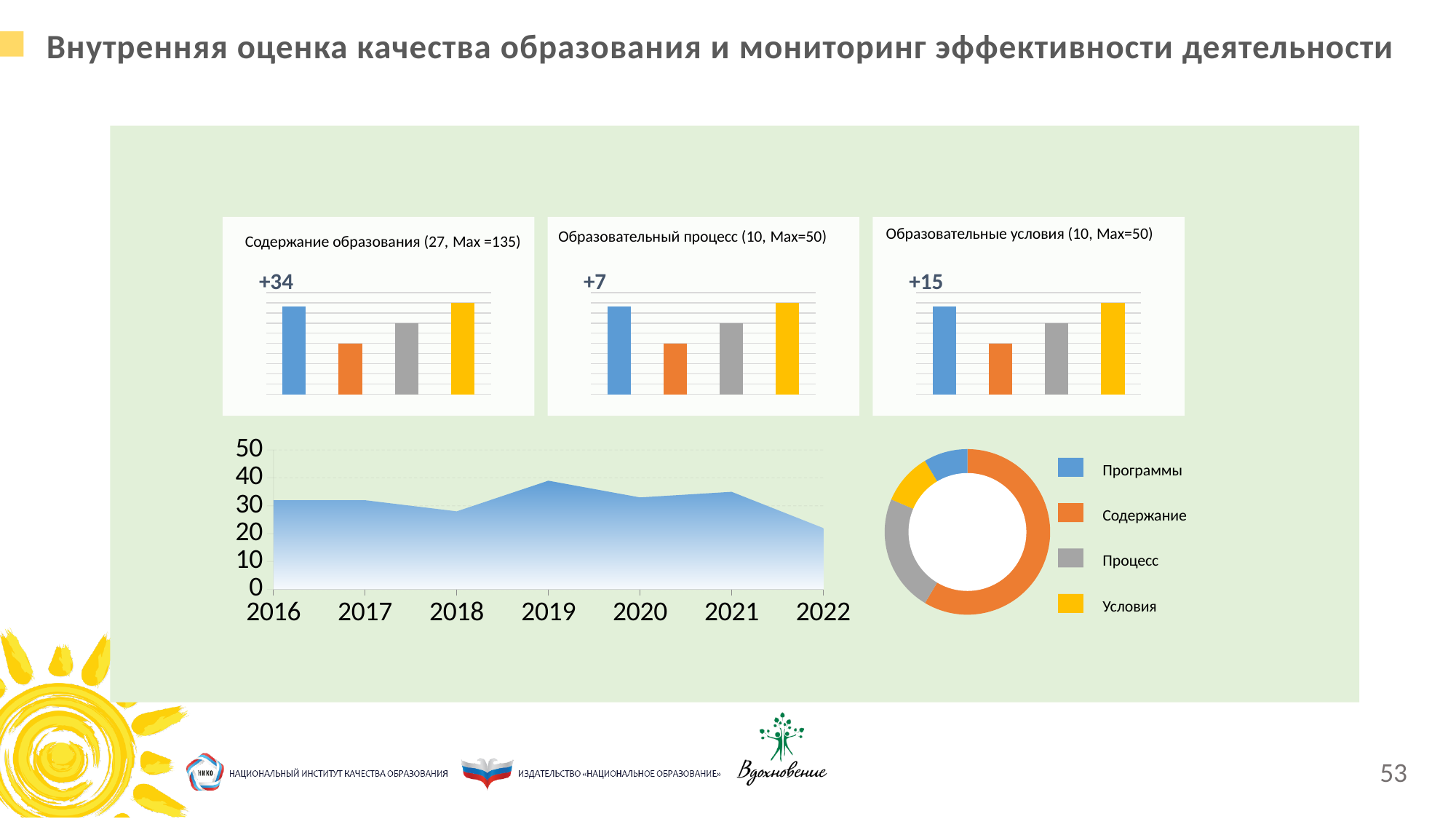
In the bottom-left area chart, which year has the lowest value? 2022 How many bars are in the chart titled 'Образовательный процесс (10, Max=50)'? 4 What type of chart is the chart titled 'Содержание образования (27, Max =135)'? bar chart In the bottom-left area chart, does the value rise or fall from 2021 to 2022? fall What type of chart is the chart at the bottom left with years 2016 to 2022 on the x axis? area chart In the bottom-left area chart, which year has the highest value? 2019 What number is printed above the bars in the chart titled 'Образовательные условия (10, Max=50)'? +15 In the donut chart on the bottom right, which category has the largest slice? Содержание In the bottom-left area chart, is the value for 2019 greater or less than 30? greater How many entries does the legend of the donut chart on the bottom right list? 4 In the bottom-left area chart, how many years are shown on the x axis? 7 In the bottom-left area chart, is the value for 2022 greater or less than 30? less